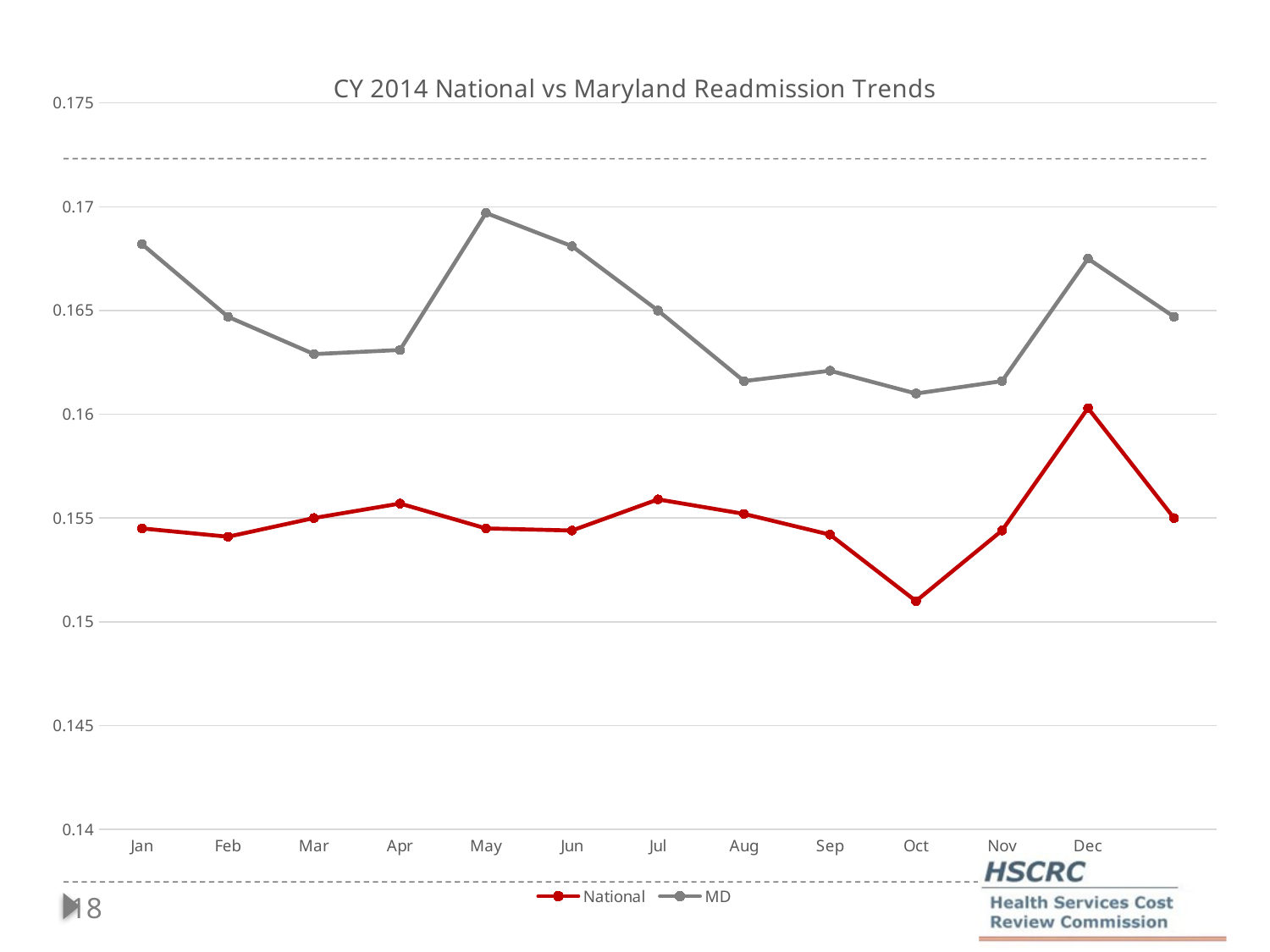
In which month does the MD series reach its lowest value? Oct In which month does the MD series reach its highest value? May Is the value for National in Oct greater or less than 0.155? less How many series does the legend list? 2 What kind of chart is shown on the slide? line chart Is the value for MD in May greater or less than 0.165? greater In Jan, which series has the higher value, National or MD? MD Which colour is used for the National series? red Does the MD series rise or fall from Jan to Mar? fall What is the title of the chart? CY 2014 National vs Maryland Readmission Trends In which month does the National series reach its highest value? Dec In which month does the National series reach its lowest value? Oct